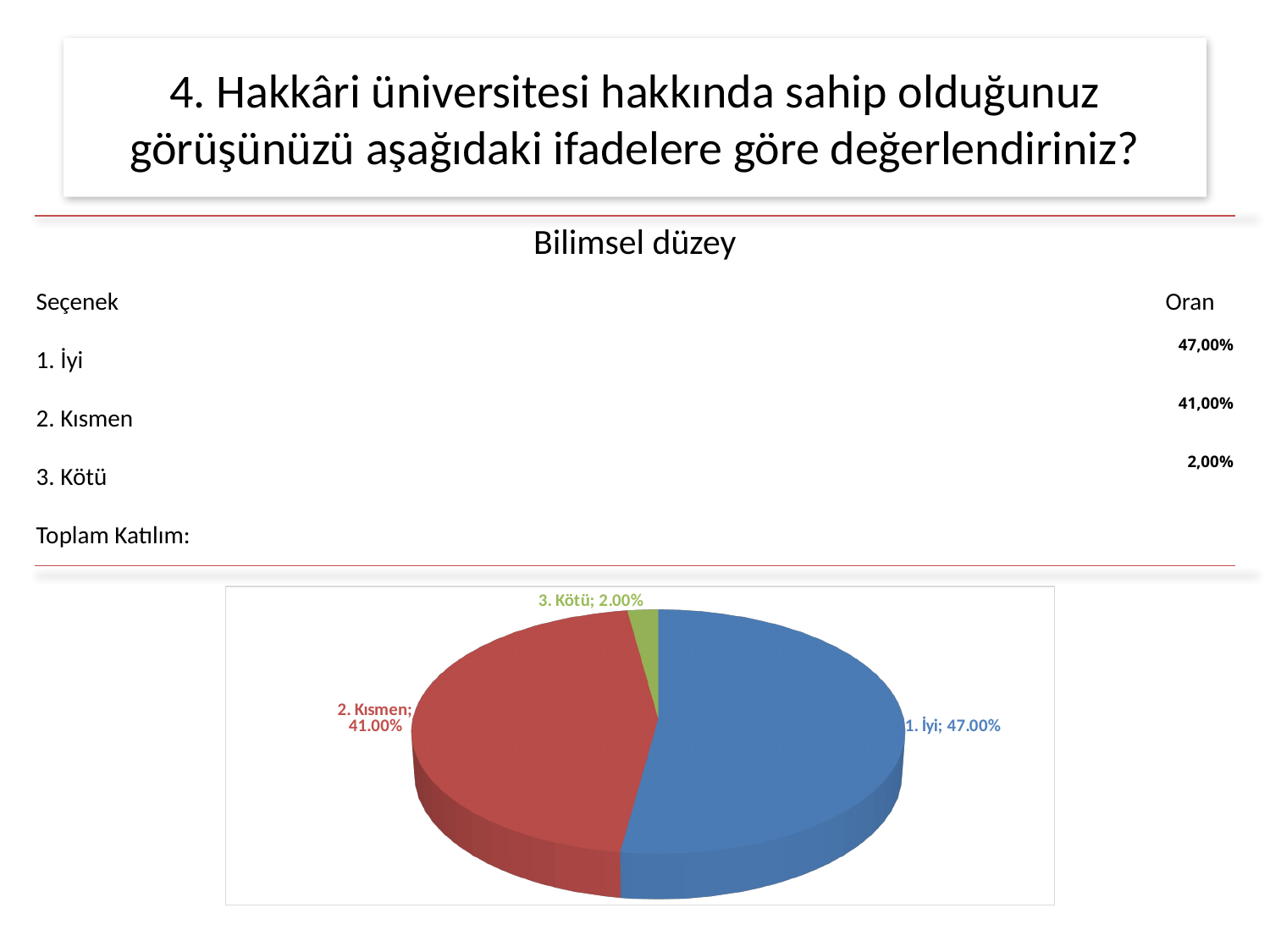
Which is larger in the pie chart, the slice for "2. Kısmen" or the slice for "3. Kötü"? 2. Kısmen What colour is the slice for "1. İyi" in the pie chart? blue What is the value shown for the slice labelled "1. İyi" in the pie chart? 47.00% What is the value shown for the slice labelled "2. Kısmen" in the pie chart? 41.00% What kind of chart is shown on the slide? pie chart What colour is the slice for "3. Kötü" in the pie chart? green How many slices does the pie chart have? 3 What is the difference between the values for "2. Kısmen" and "3. Kötü" in the pie chart? 39.00% Which slice of the pie chart is the largest? 1. İyi What is the difference between the values for "1. İyi" and "2. Kısmen" in the pie chart? 6.00% What is the value shown for the slice labelled "3. Kötü" in the pie chart? 2.00% Which slice of the pie chart is the smallest? 3. Kötü